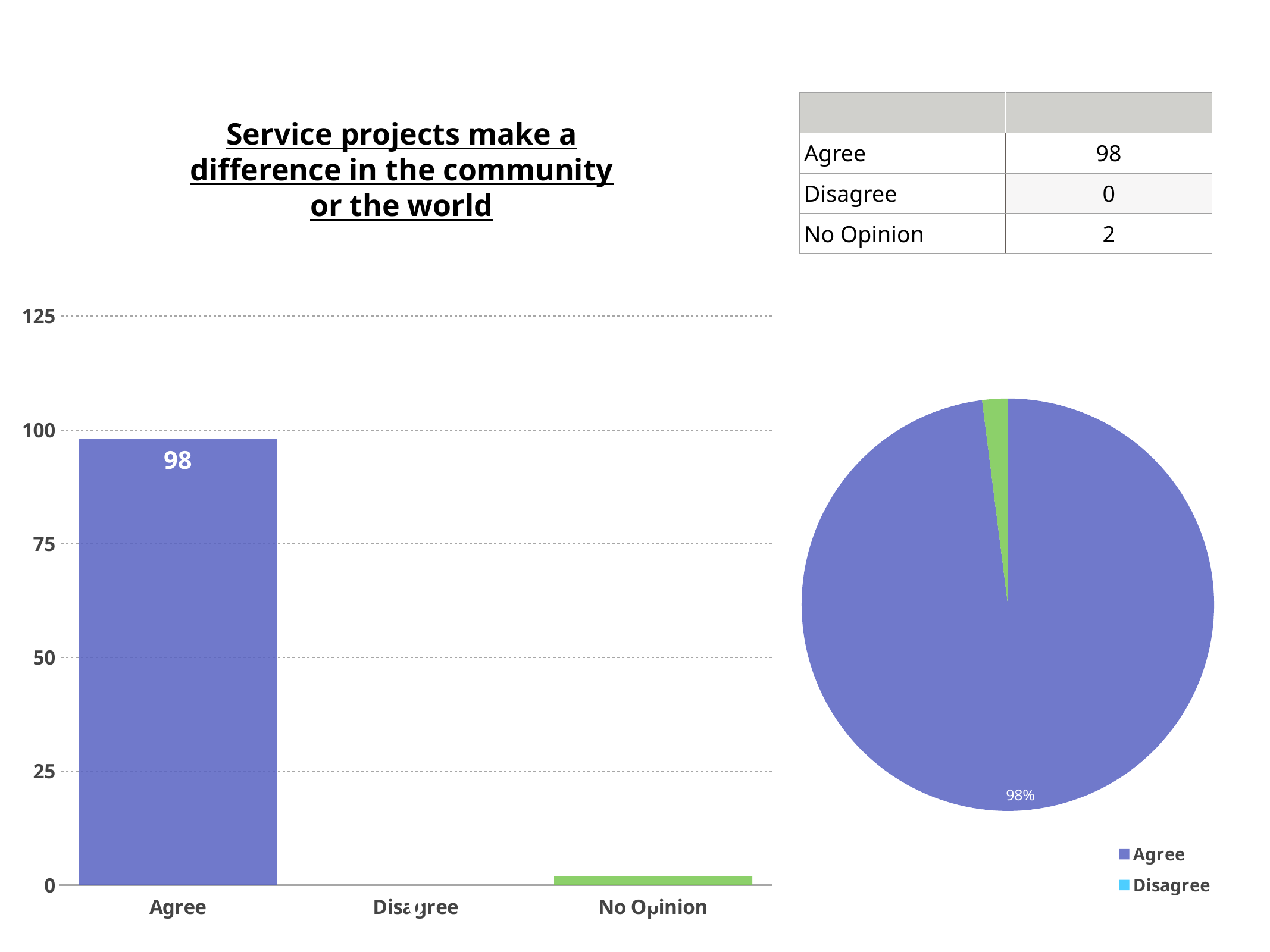
What is the title of the bar chart? Service projects make a difference in the community or the world In the bar chart, is the value for Agree greater or less than 100? less In the bar chart, which category has the highest value? Agree What is the difference between the Agree value and the No Opinion value shown on the slide? 96 What type of chart is on the right side of the slide? pie chart What type of chart is on the left side of the slide? bar chart In the bar chart, which is larger, the value for Agree or the value for No Opinion? Agree How many categories are shown on the x axis of the bar chart? 3 In the bar chart, what is the value for Agree? 98 In the pie chart, what share of the pie does the Agree slice represent? 98% In the bar chart, is the value for No Opinion greater or less than 25? less In the bar chart, which category has the lowest value? Disagree